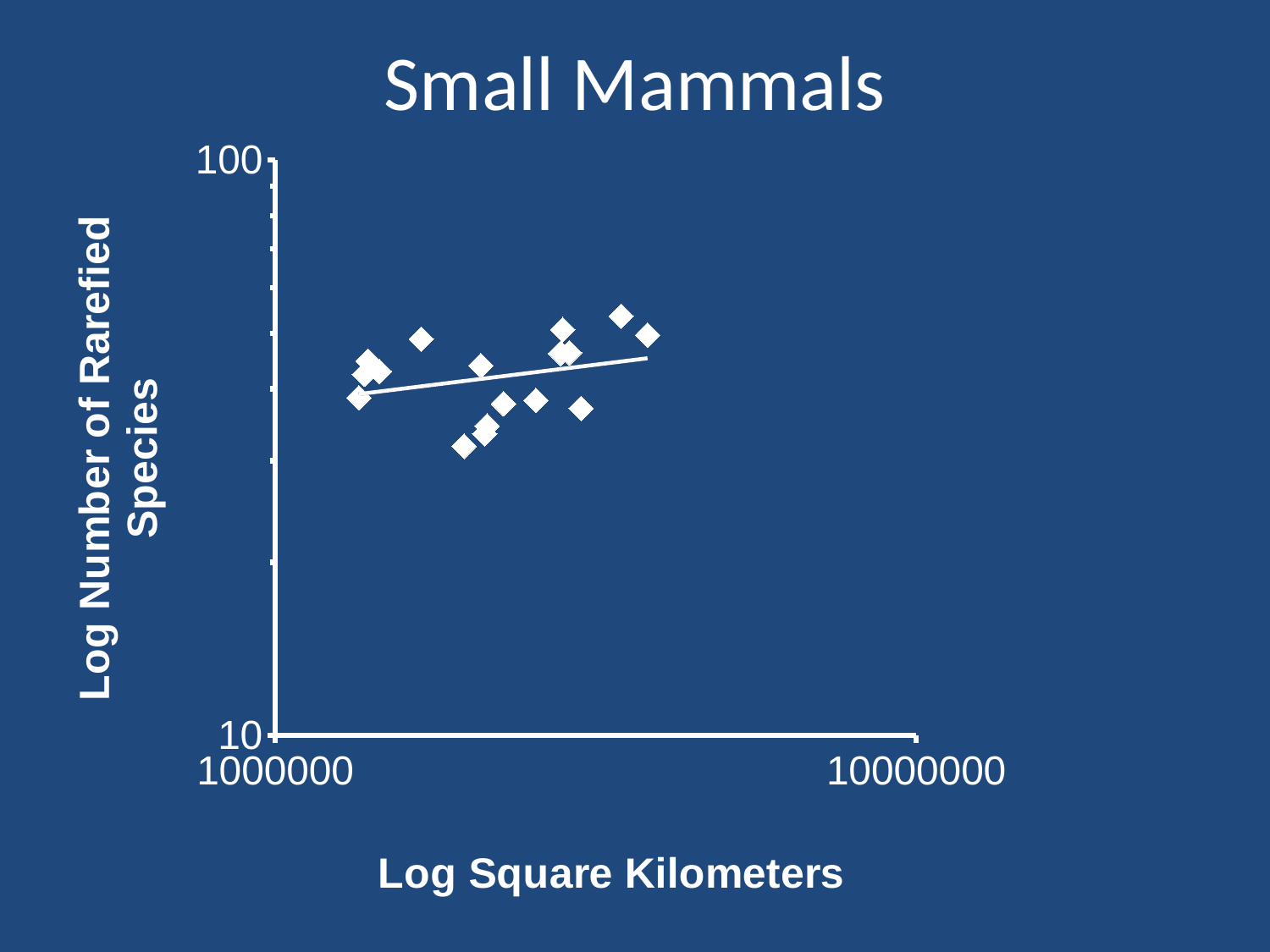
Does the fitted trend line rise or fall as Log Square Kilometers increases? rise What is the title of the chart? Small Mammals Are the plotted values on the y axis greater or less than 10? greater Are the plotted points' x values greater or less than 10000000? less Are the plotted values on the y axis greater or less than 100? less What kind of chart is shown on the slide? scatter plot What is the label of the y axis? Log Number of Rarefied Species